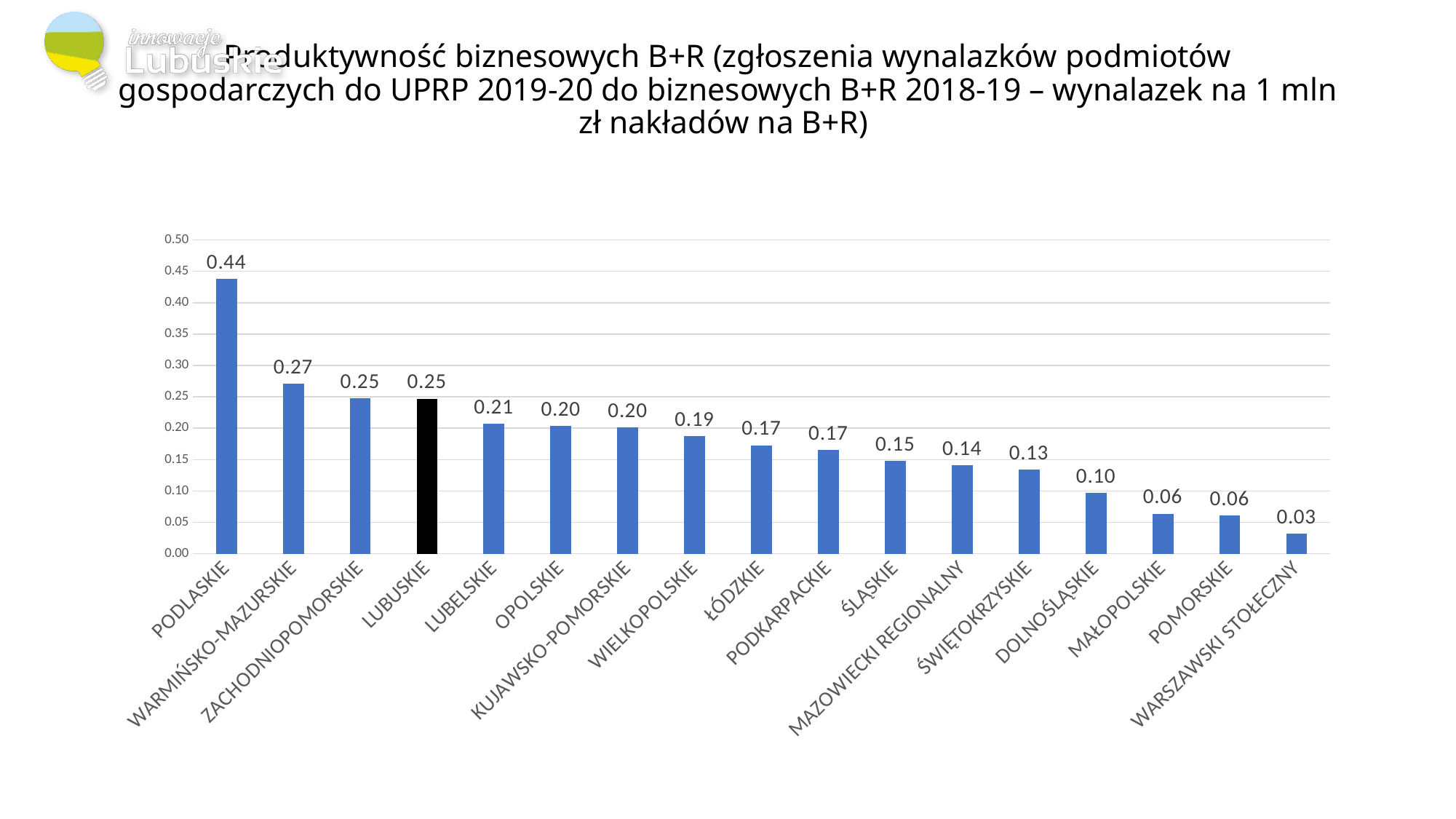
Is the value for DOLNOŚLĄSKIE greater or less than 0.15? less What kind of chart is shown on the slide? bar chart How many categories are shown on the x axis? 17 Do the values rise or fall from left to right along the x axis? fall Which category has the highest value? PODLASKIE Which is larger, the value for LUBELSKIE or the value for ŚLĄSKIE? LUBELSKIE What is the value for LUBUSKIE? 0.25 Which bar is coloured black instead of blue? LUBUSKIE Which category has the lowest value? WARSZAWSKI STOŁECZNY What is the difference between the values for PODLASKIE and WARMIŃSKO-MAZURSKIE? 0.17 What is the value for WIELKOPOLSKIE? 0.19 What is the value for PODLASKIE? 0.44